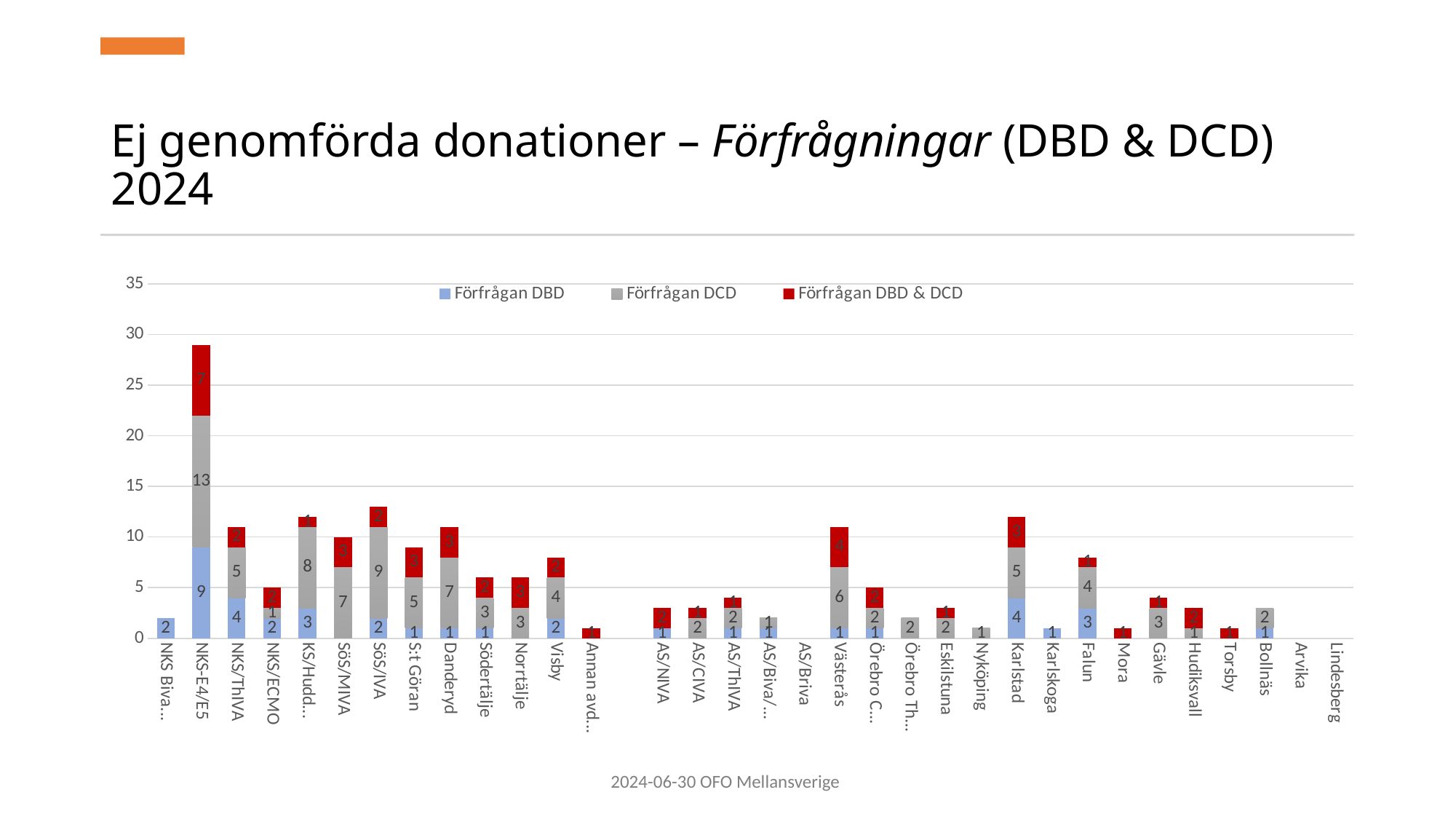
Is the total stacked bar for NKS-E4/E5 greater or less than 25? greater What is the Förfrågan DBD value for Karlstad? 4 Which is larger, the Förfrågan DCD value for KS/Hudd... or for Danderyd? KS/Hudd... What kind of chart is shown on the slide? Stacked bar chart How many series does the legend list? 3 Which colour represents Förfrågan DBD & DCD in the chart? Red What is the Förfrågan DBD & DCD value for Västerås? 4 What is the Förfrågan DCD value for NKS-E4/E5? 13 Which category has the highest total stacked bar? NKS-E4/E5 What is the difference between the Förfrågan DCD values for NKS-E4/E5 and SöS/IVA? 4 What is the total of the stacked bar for NKS-E4/E5? 29 What is the total of the stacked bar for Karlstad? 12